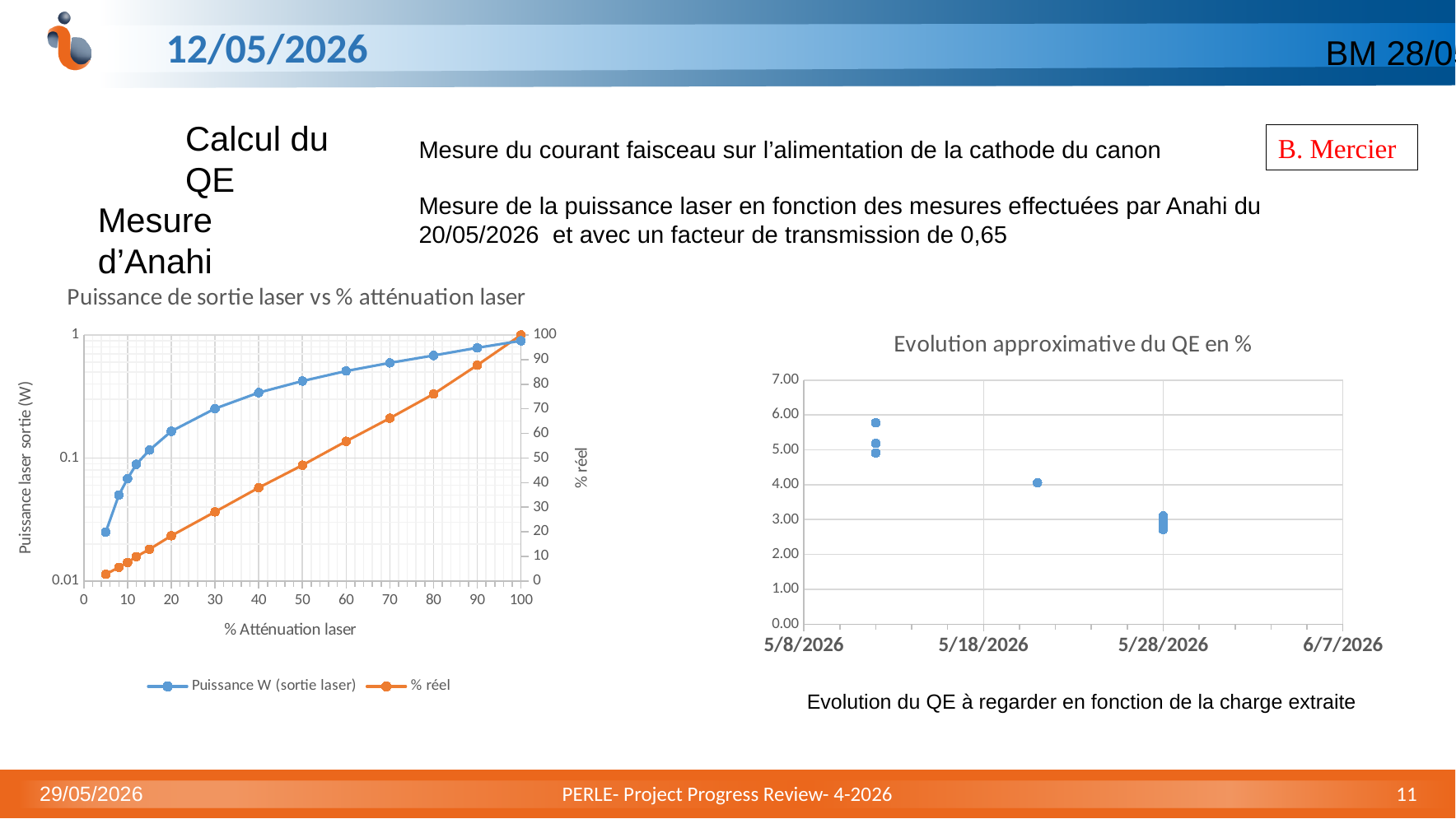
In 'Evolution approximative du QE en %', is the highest plotted point greater or less than 5.00? greater How many series does the legend of 'Puissance de sortie laser vs % atténuation laser' list? 2 In 'Puissance de sortie laser vs % atténuation laser', is the % réel value at 70% attenuation greater or less than 60? greater In 'Puissance de sortie laser vs % atténuation laser', do the Puissance W (sortie laser) values rise or fall as % attenuation increases? rise What kind of chart is 'Puissance de sortie laser vs % atténuation laser'? line chart In 'Puissance de sortie laser vs % atténuation laser', is the Puissance W (sortie laser) value at 40% attenuation greater or less than 0.1? greater In 'Puissance de sortie laser vs % atténuation laser', what is the % réel value at 100% attenuation? 100 In 'Puissance de sortie laser vs % atténuation laser', what are the two legend entries? Puissance W (sortie laser) and % réel In 'Puissance de sortie laser vs % atténuation laser', what is the x-axis title? % Atténuation laser In 'Evolution approximative du QE en %', do the QE values rise or fall over time? fall